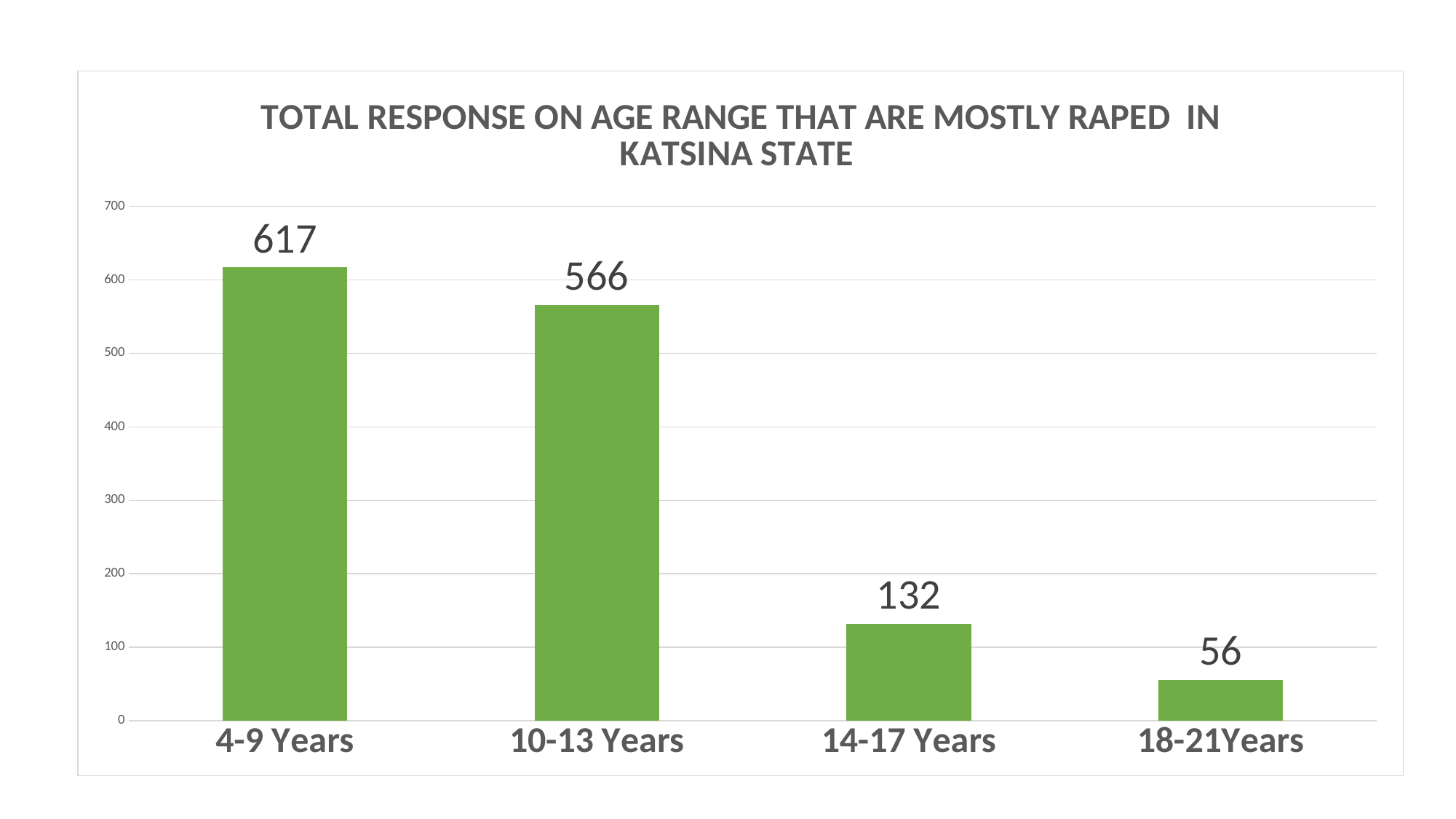
Do the values rise or fall from left to right across the age ranges? Fall Which age range has the lowest value? 18-21Years What is the value for 14-17 Years? 132 What is the value for 4-9 Years? 617 What is the difference between the values for 14-17 Years and 18-21Years? 76 What is the value for 18-21Years? 56 What is the difference between the values for 4-9 Years and 10-13 Years? 51 Which is larger, the value for 10-13 Years or the value for 14-17 Years? 10-13 Years What is the value for 10-13 Years? 566 What kind of chart is shown on the slide? Bar chart Which age range has the highest value? 4-9 Years How many age range categories are shown on the chart? 4